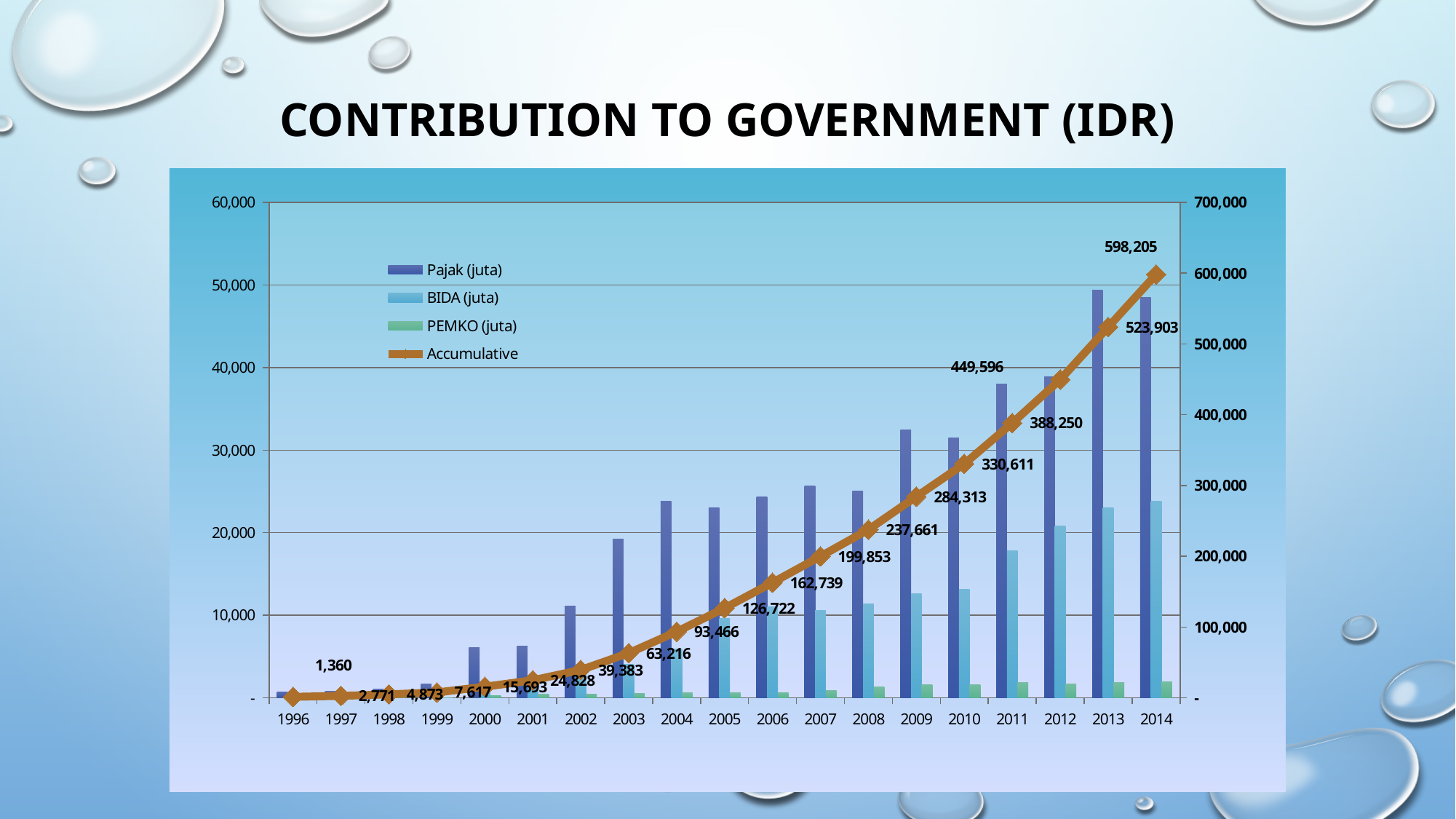
What is the Accumulative value for 2014? 598,205 What is the difference between the Accumulative values for 2014 and 2013? 74,302 In which year is the Accumulative value lowest? 1996 Is the BIDA (juta) value for 2014 greater or less than 30,000? less How many years are shown on the x axis? 19 How many series does the legend list? 4 What is the Accumulative value for 1996? 1,360 What is the Accumulative value for 2010? 330,611 Is the Pajak (juta) value for 2013 greater or less than 40,000? greater Which is larger, the Accumulative value for 2008 or for 2009? 2009 In which year is the Accumulative value highest? 2014 What is the Accumulative value for 2005? 126,722